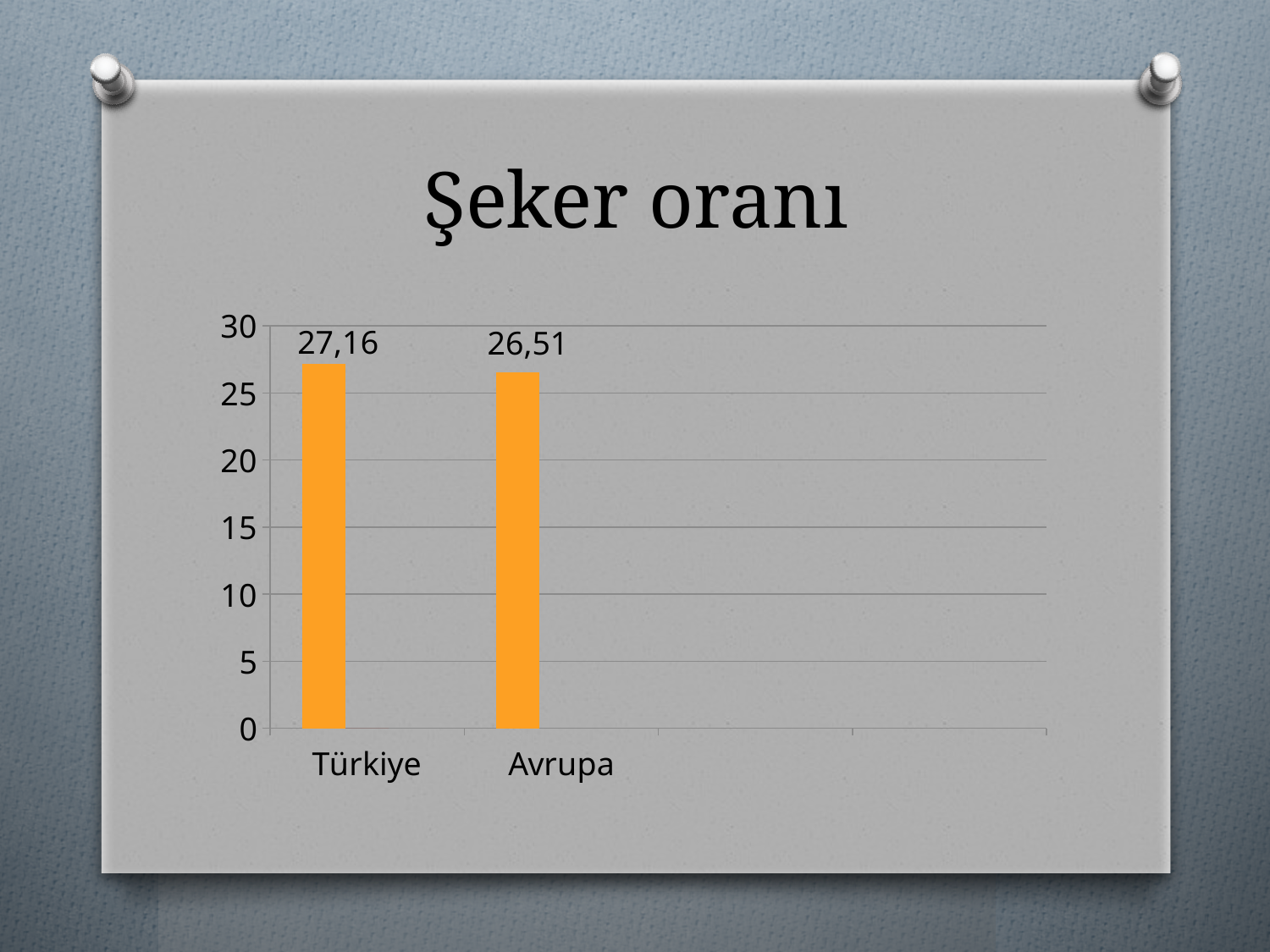
What kind of chart is shown on the slide? bar chart What colour are the bars in the chart? orange Is the value for Avrupa greater or less than 25? greater Is the value for Türkiye greater or less than 30? less Which category has the highest value? Türkiye What is the value for Avrupa? 26,51 What is the difference between the values for Türkiye and Avrupa? 0,65 What is the title of the chart? Şeker oranı Which category has the lowest value? Avrupa Which is larger, the value for Türkiye or the value for Avrupa? Türkiye How many categories are shown on the chart? 2 What is the value for Türkiye? 27,16